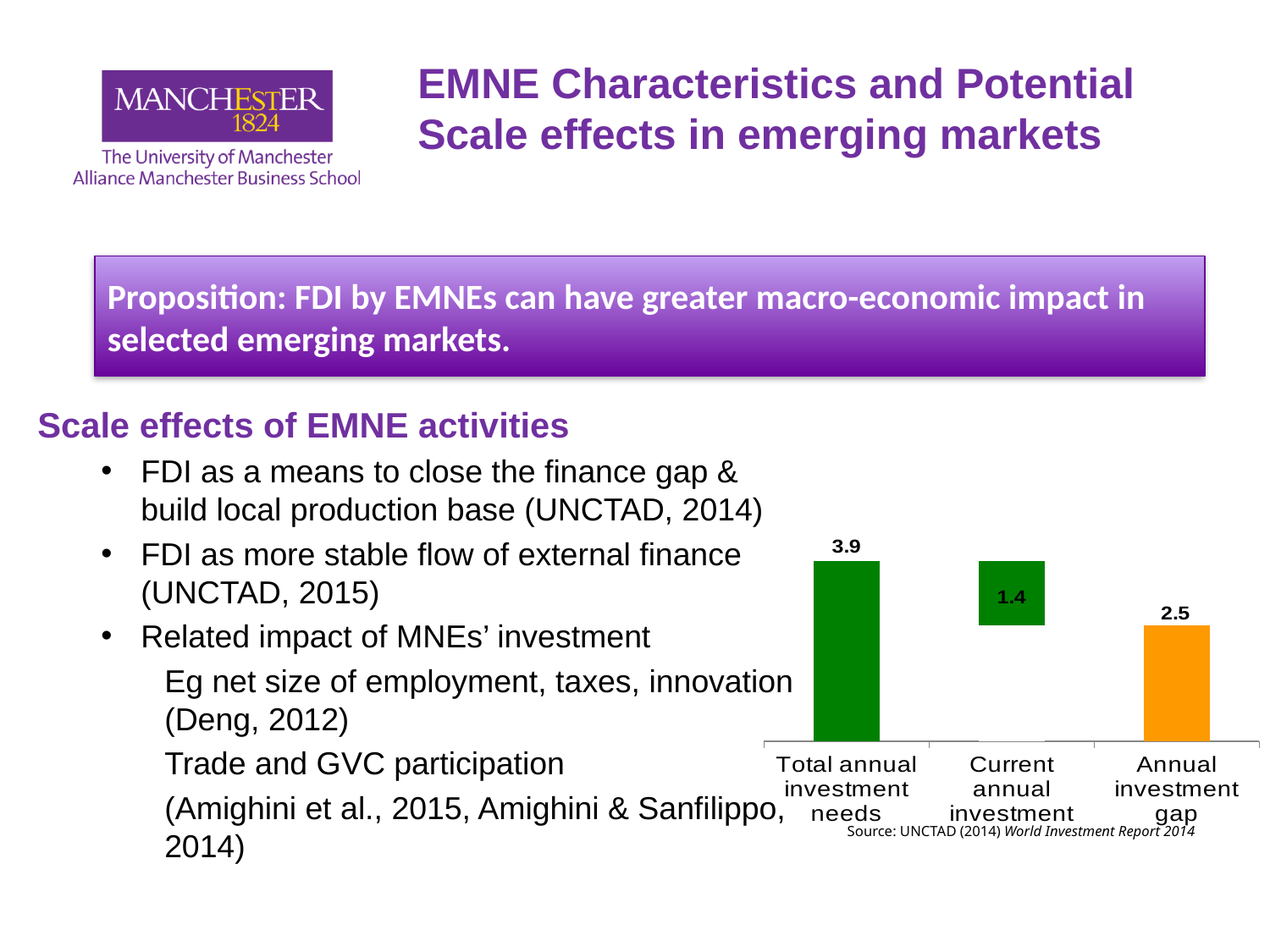
Which is larger, Annual investment gap or Current annual investment? Annual investment gap What kind of chart is shown on the slide? Bar chart Which category has the lowest value? Current annual investment What is the value for Current annual investment? 1.4 What is the difference between Total annual investment needs and Current annual investment? 2.5 How many categories are shown in the chart? 3 What is the difference between Annual investment gap and Current annual investment? 1.1 What is the value for Annual investment gap? 2.5 What source is cited below the chart? UNCTAD (2014) World Investment Report 2014 What colour is the bar for Annual investment gap? Orange What is the value for Total annual investment needs? 3.9 Which category has the highest value? Total annual investment needs